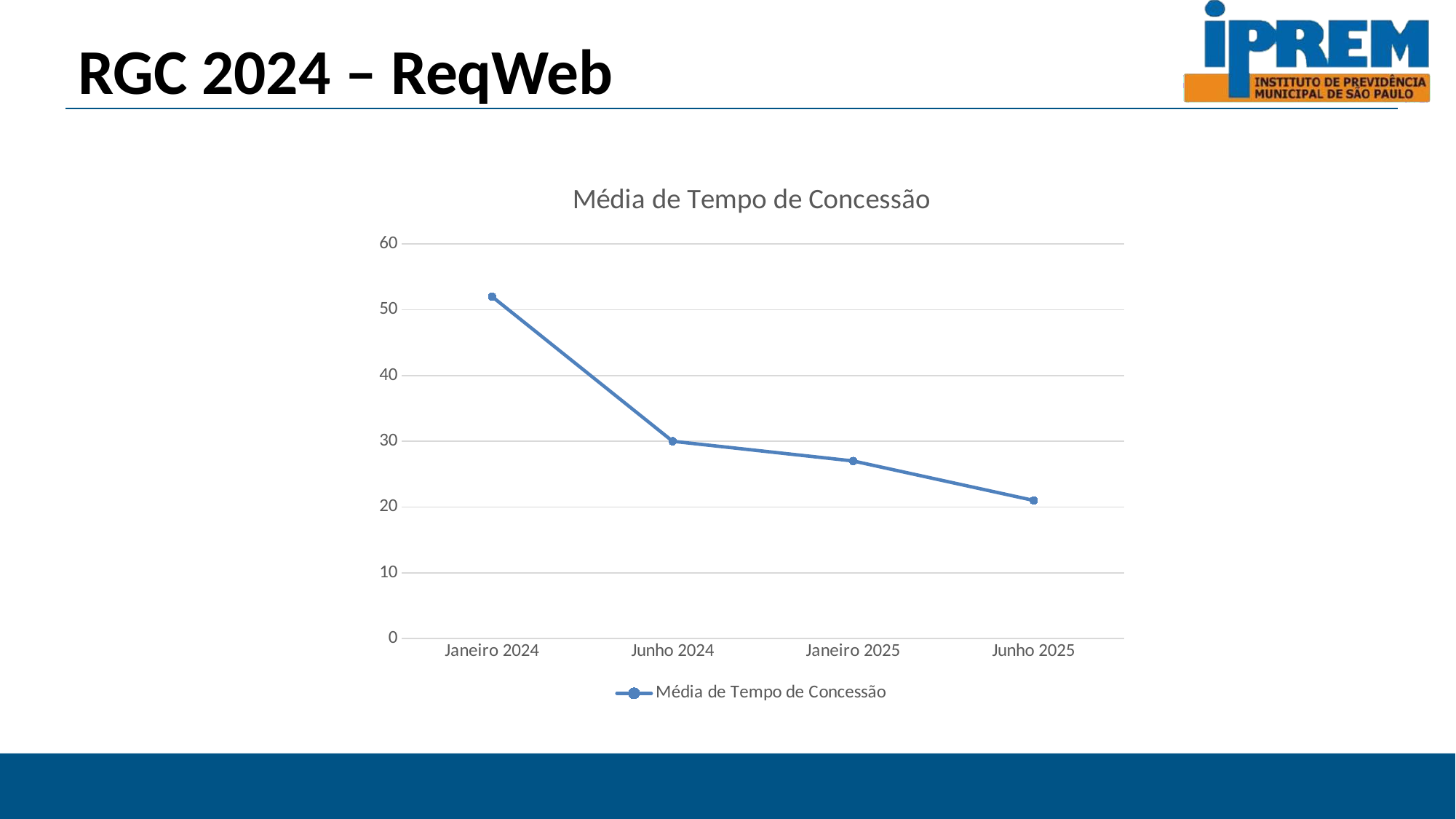
What is the value for Junho 2024? 30 Is the value for Junho 2025 greater or less than 30? less How many data points are plotted on the chart? 4 Is the value for Janeiro 2024 greater or less than 50? greater Is the value for Janeiro 2025 greater or less than 30? less Do the values rise or fall from Janeiro 2024 to Junho 2025? fall What is the title of the chart? Média de Tempo de Concessão Which is larger, the value for Janeiro 2024 or the value for Junho 2024? Janeiro 2024 Which period has the highest value? Janeiro 2024 How many series does the legend list? 1 What kind of chart is shown on the slide? line chart Which period has the lowest value? Junho 2025